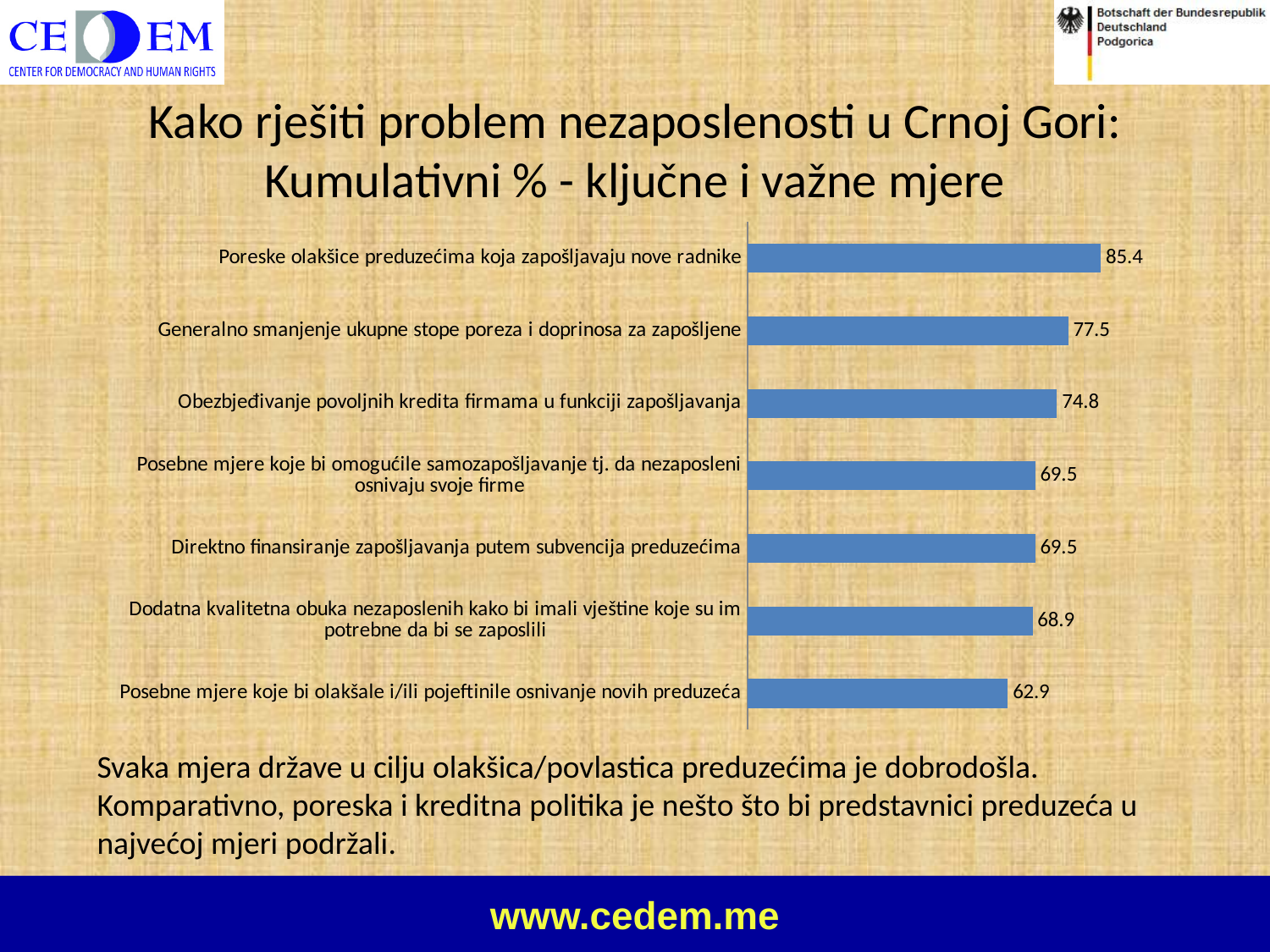
Which is larger: the value for "Generalno smanjenje ukupne stope poreza i doprinosa za zapošljene" or for "Obezbjeđivanje povoljnih kredita firmama u funkciji zapošljavanja"? Generalno smanjenje ukupne stope poreza i doprinosa za zapošljene What kind of chart is shown on the slide? Bar chart What is the difference between the values for "Generalno smanjenje ukupne stope poreza i doprinosa za zapošljene" and "Direktno finansiranje zapošljavanja putem subvencija preduzećima"? 8 What is the value for "Posebne mjere koje bi olakšale i/ili pojeftinile osnivanje novih preduzeća"? 62.9 What is the value for "Generalno smanjenje ukupne stope poreza i doprinosa za zapošljene"? 77.5 Which category has the highest value? Poreske olakšice preduzećima koja zapošljavaju nove radnike What is the difference between the values for "Poreske olakšice preduzećima koja zapošljavaju nove radnike" and "Posebne mjere koje bi olakšale i/ili pojeftinile osnivanje novih preduzeća"? 22.5 What is the value for "Obezbjeđivanje povoljnih kredita firmama u funkciji zapošljavanja"? 74.8 What is the value for "Poreske olakšice preduzećima koja zapošljavaju nove radnike"? 85.4 What is the value for "Dodatna kvalitetna obuka nezaposlenih kako bi imali vještine koje su im potrebne da bi se zaposlili"? 68.9 Which category has the lowest value? Posebne mjere koje bi olakšale i/ili pojeftinile osnivanje novih preduzeća How many categories are shown in the chart? 7